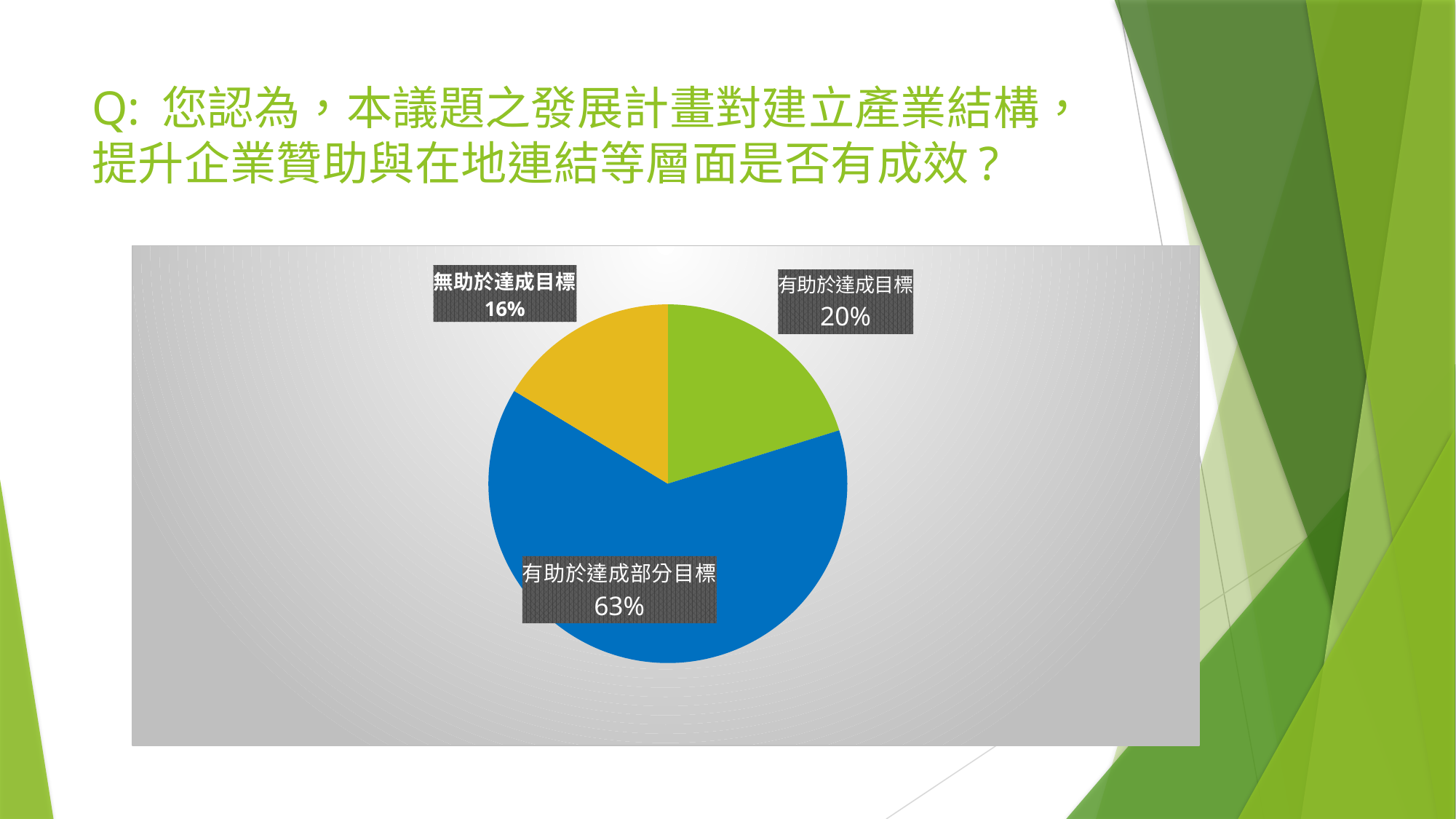
What colour is the slice for 有助於達成部分目標? blue What share of the pie does 有助於達成部分目標 represent? 63% What colour is the slice for 無助於達成目標? yellow What is the value shown for 無助於達成目標? 16% Which is larger, the share for 有助於達成目標 or the share for 無助於達成目標? 有助於達成目標 What is the difference between the shares of 有助於達成目標 and 無助於達成目標? 4% How many slices does the pie chart have? 3 Which category has the largest share of the pie? 有助於達成部分目標 Which category has the smallest share of the pie? 無助於達成目標 What is the difference between the shares of 有助於達成部分目標 and 有助於達成目標? 43% What is the value shown for 有助於達成目標? 20% What kind of chart is shown on the slide? pie chart